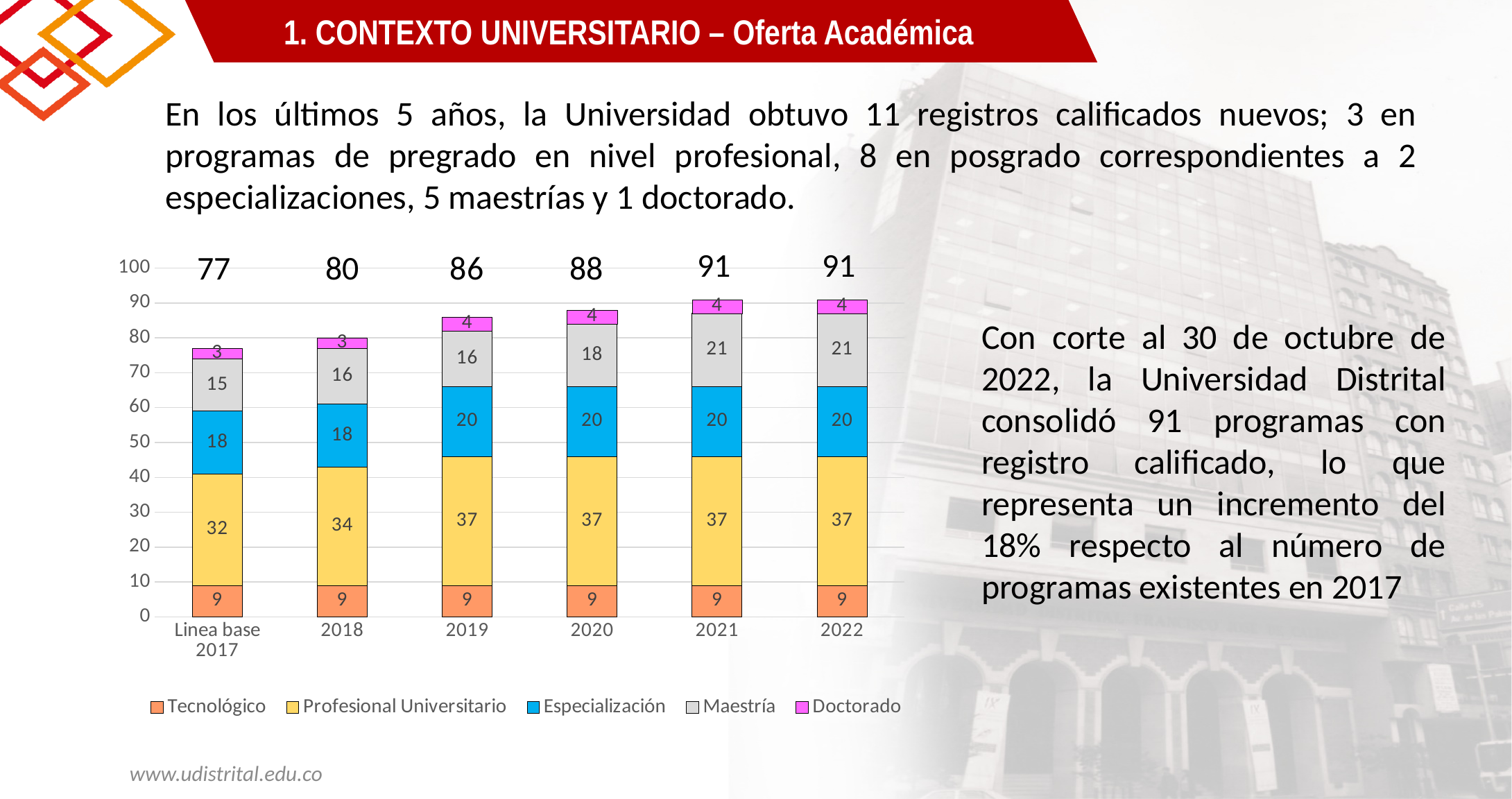
How many categories (years) are shown on the x axis? 6 How many series does the legend list? 5 Which is larger, the Maestría value in 2021 or the Maestría value in 2019? 2021 Do the bar totals rise or fall from Linea base 2017 to 2021? Rise What is the value for Doctorado in Linea base 2017? 3 What is the value for Profesional Universitario in 2018? 34 What is the difference between the total for 2022 and the total for Linea base 2017? 14 What kind of chart is shown on the slide? Stacked bar chart Which year has the lowest total? Linea base 2017 What is the value for Maestría in 2020? 18 Which series is shown in blue in the legend? Especialización What is the total of the stacked bar for 2019? 86